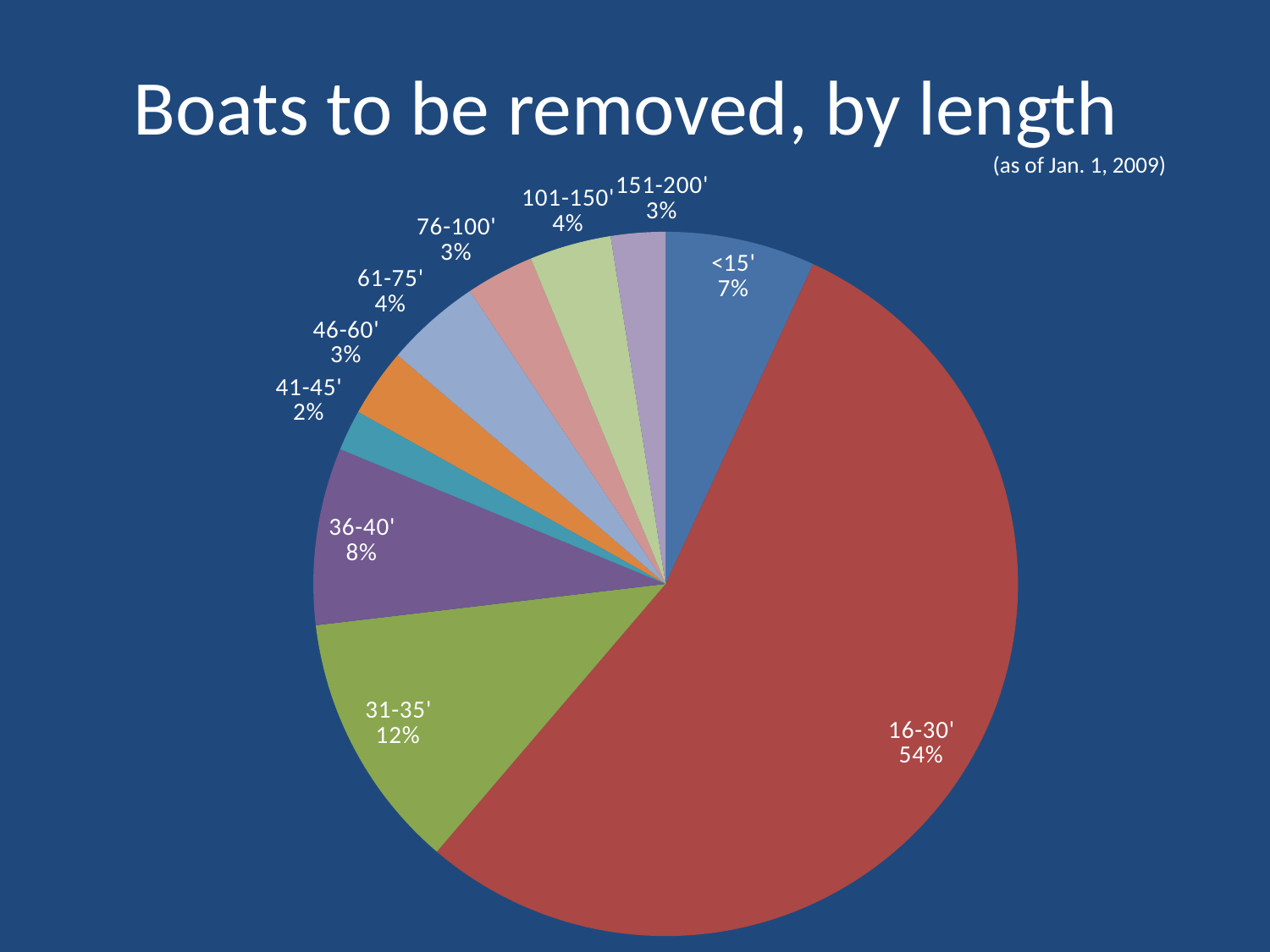
What percentage is shown for the 101-150' category? 4% What kind of chart is shown on the slide? pie chart As of what date is the chart's data reported? Jan. 1, 2009 What percentage is shown for the <15' category? 7% Which length category has the smallest share of boats to be removed? 41-45' Which length category has the largest share of boats to be removed? 16-30' How many slices does the pie chart have? 10 What percentage is shown for the 31-35' category? 12% Which is larger, the share for 36-40' or the share for <15'? 36-40' What share of the pie is the 16-30' slice? 54% What is the title of the chart? Boats to be removed, by length What is the difference in percentage points between the 16-30' slice and the 31-35' slice? 42